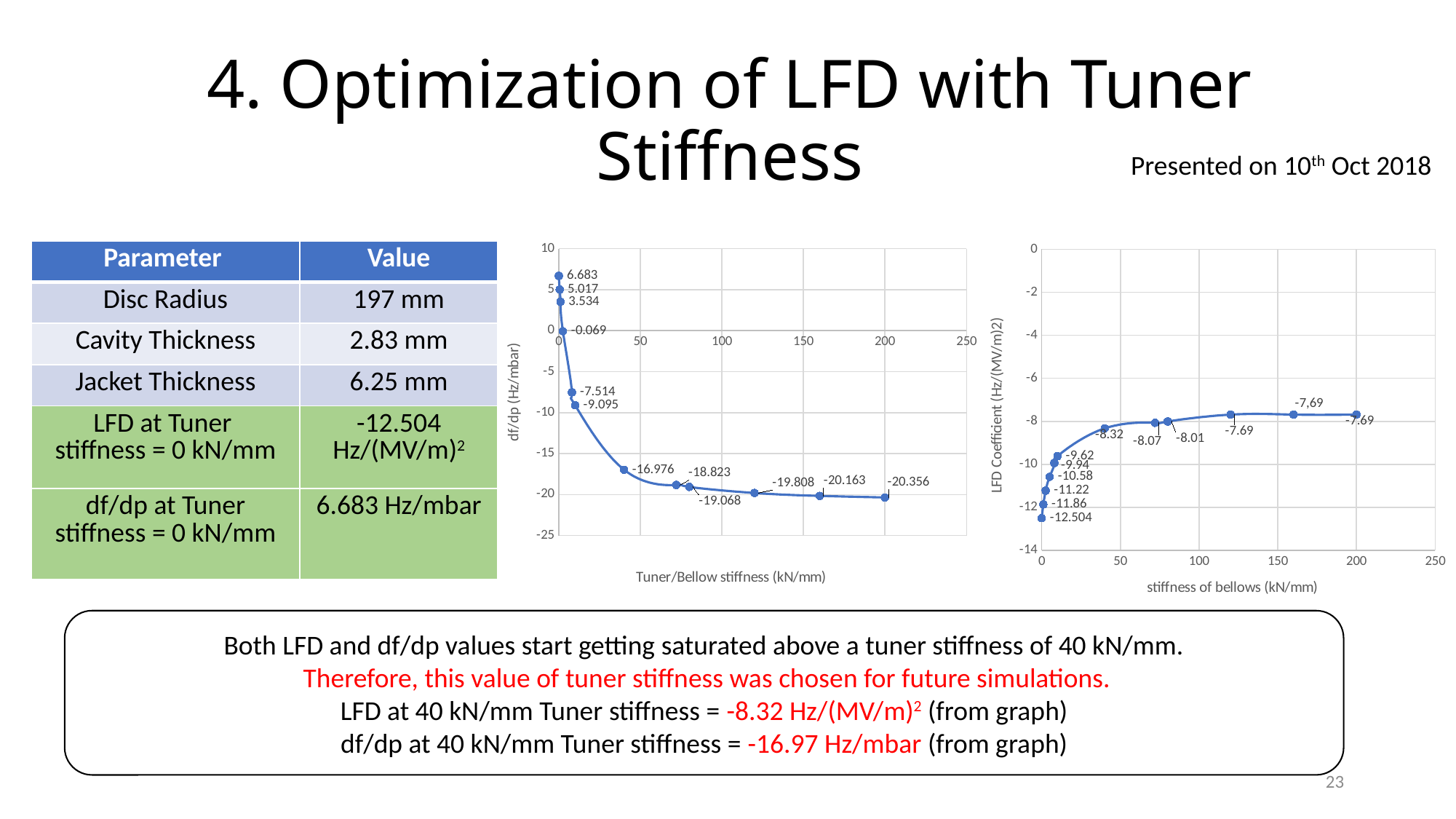
In the left chart (df/dp vs Tuner/Bellow stiffness), what is the difference between the df/dp value at 40 kN/mm (-16.976) and at 200 kN/mm (-20.356)? 3.38 In the left chart (df/dp vs Tuner/Bellow stiffness), what is the highest df/dp value labelled? 6.683 In the right chart (LFD Coefficient vs stiffness of bellows), what is the lowest LFD coefficient value labelled? -12.504 In the left chart (df/dp vs Tuner/Bellow stiffness), what is the label of the x axis? Tuner/Bellow stiffness (kN/mm) What kind of chart is the right chart (LFD Coefficient vs stiffness of bellows)? line chart In the left chart (df/dp vs Tuner/Bellow stiffness), what is the lowest df/dp value labelled? -20.356 In the left chart (df/dp vs Tuner/Bellow stiffness), what is the df/dp value at a tuner stiffness of 200 kN/mm? -20.356 In the right chart (LFD Coefficient vs stiffness of bellows), is the LFD coefficient at 40 kN/mm greater or less than -10? greater In the right chart (LFD Coefficient vs stiffness of bellows), what is the difference between the LFD coefficient at 0 kN/mm (-12.504) and at 40 kN/mm (-8.32)? 4.184 In the left chart (df/dp vs Tuner/Bellow stiffness), does df/dp generally rise or fall as tuner stiffness increases? fall In the right chart (LFD Coefficient vs stiffness of bellows), what is the LFD coefficient at a bellows stiffness of 200 kN/mm? -7.69 In the right chart (LFD Coefficient vs stiffness of bellows), does the LFD coefficient rise or fall as bellows stiffness increases? rise